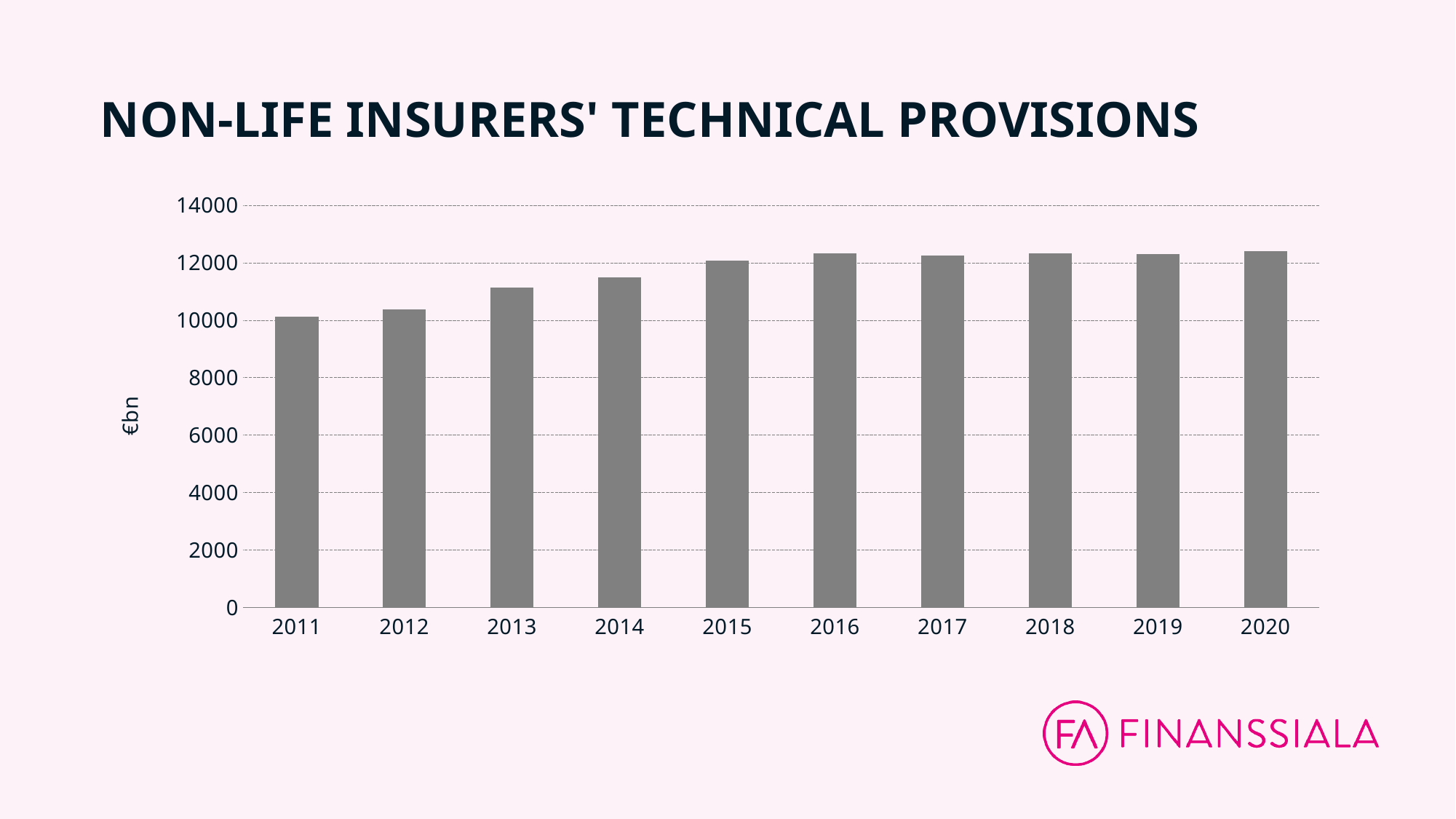
Which year has the lowest technical provisions? 2011 Do the values generally rise or fall from 2011 to 2020? rise What unit is shown on the y axis of the chart? €bn Which is larger, the value for 2012 or the value for 2015? 2015 How many years are shown on the x axis of the chart? 10 Which is larger, the value for 2011 or the value for 2020? 2020 Is the value for 2014 greater or less than 12000? less Is the value for 2018 greater or less than 14000? less Is the value for 2013 greater or less than 10000? greater What kind of chart is shown on the slide? bar chart